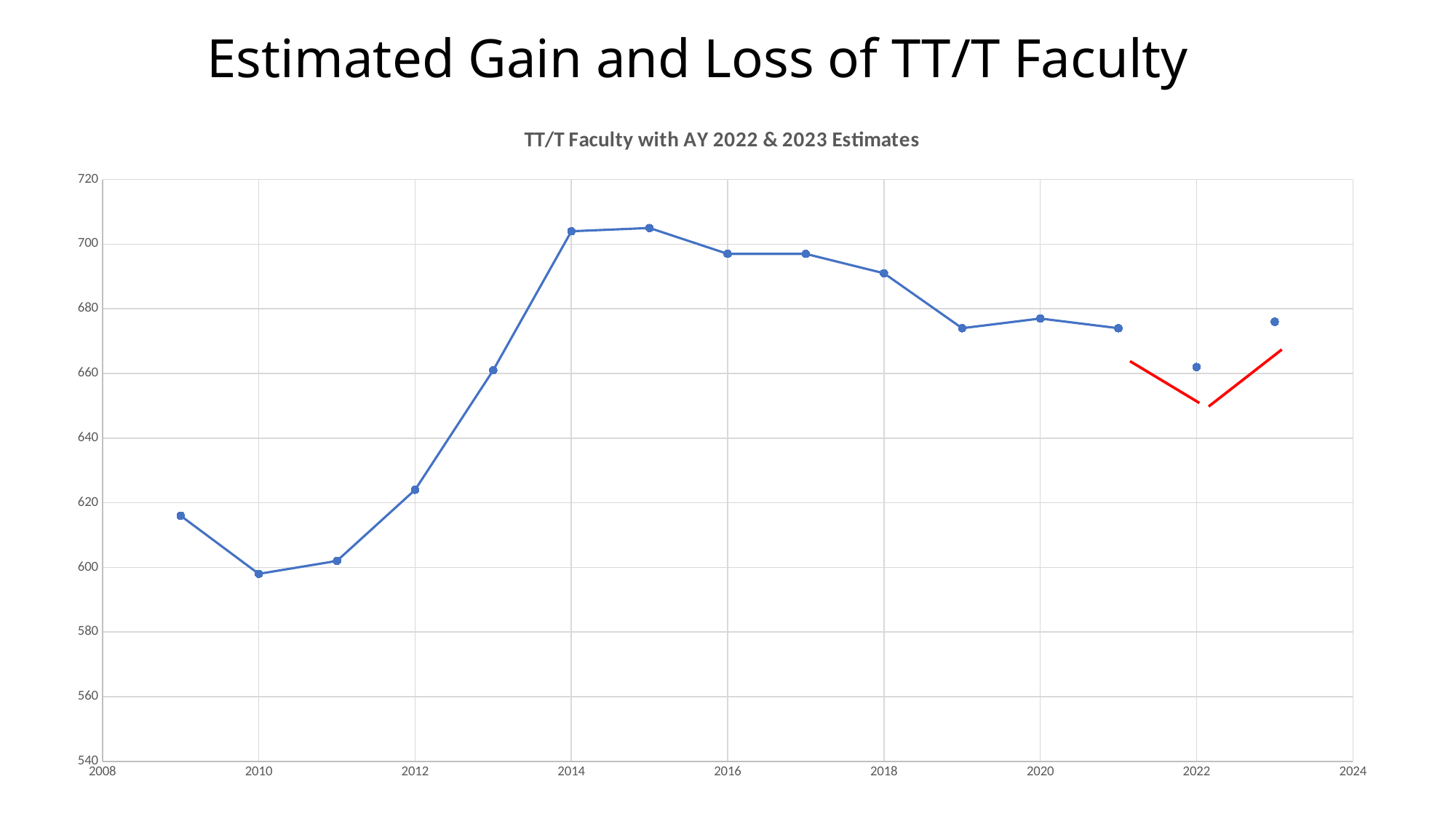
Which year has the larger value, 2018 or 2022? 2018 Is the value for 2022 greater or less than 680? less Is the value for 2018 greater or less than 680? greater Which year has the larger value, 2013 or 2014? 2014 Do the values rise or fall from 2015 to 2019? fall What kind of chart is shown on the slide? line chart Is the value for 2009 greater or less than 600? greater Do the values rise or fall from 2010 to 2015? rise How many data points are plotted on the chart? 15 What is the title of the chart? TT/T Faculty with AY 2022 & 2023 Estimates